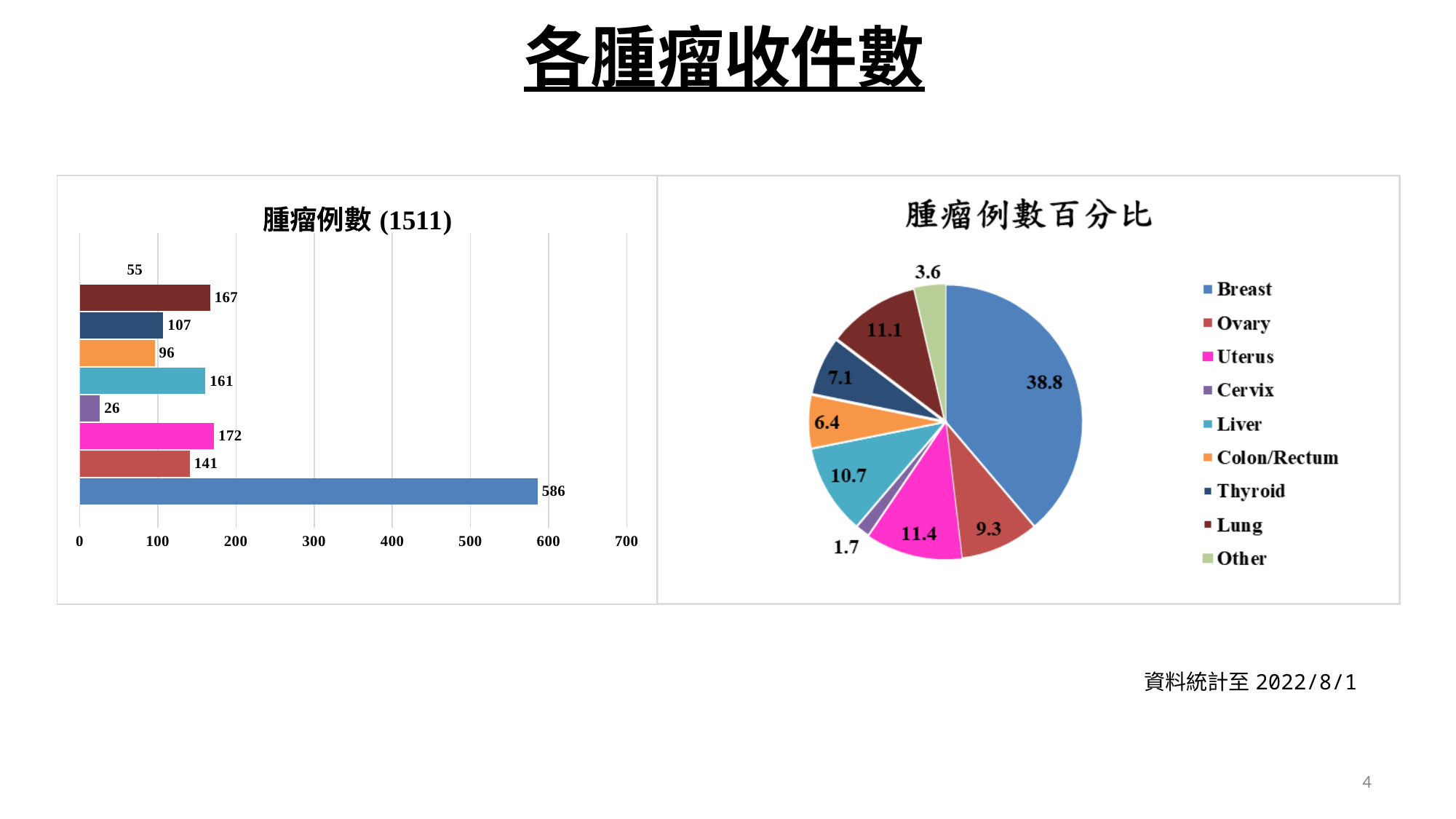
In the pie chart 腫瘤例數百分比, what is the value shown for Breast? 38.8 In the pie chart 腫瘤例數百分比, which category has the largest slice? Breast In the bar chart 腫瘤例數 (1511), what is the value of the longest bar? 586 In the pie chart 腫瘤例數百分比, which category has the smallest slice? Cervix In the bar chart 腫瘤例數 (1511), what is the value of the shortest visible bar? 26 In the pie chart 腫瘤例數百分比, what is the difference between the values for Liver and Colon/Rectum? 4.3 In the pie chart 腫瘤例數百分比, which is larger, the value for Uterus or the value for Lung? Uterus In the pie chart 腫瘤例數百分比, what is the value shown for Thyroid? 7.1 What kind of chart is the chart on the left titled 腫瘤例數 (1511)? Bar chart What total number appears in parentheses in the title of the bar chart on the left? 1511 How many categories does the legend of the pie chart 腫瘤例數百分比 list? 9 What kind of chart is the chart on the right titled 腫瘤例數百分比? Pie chart